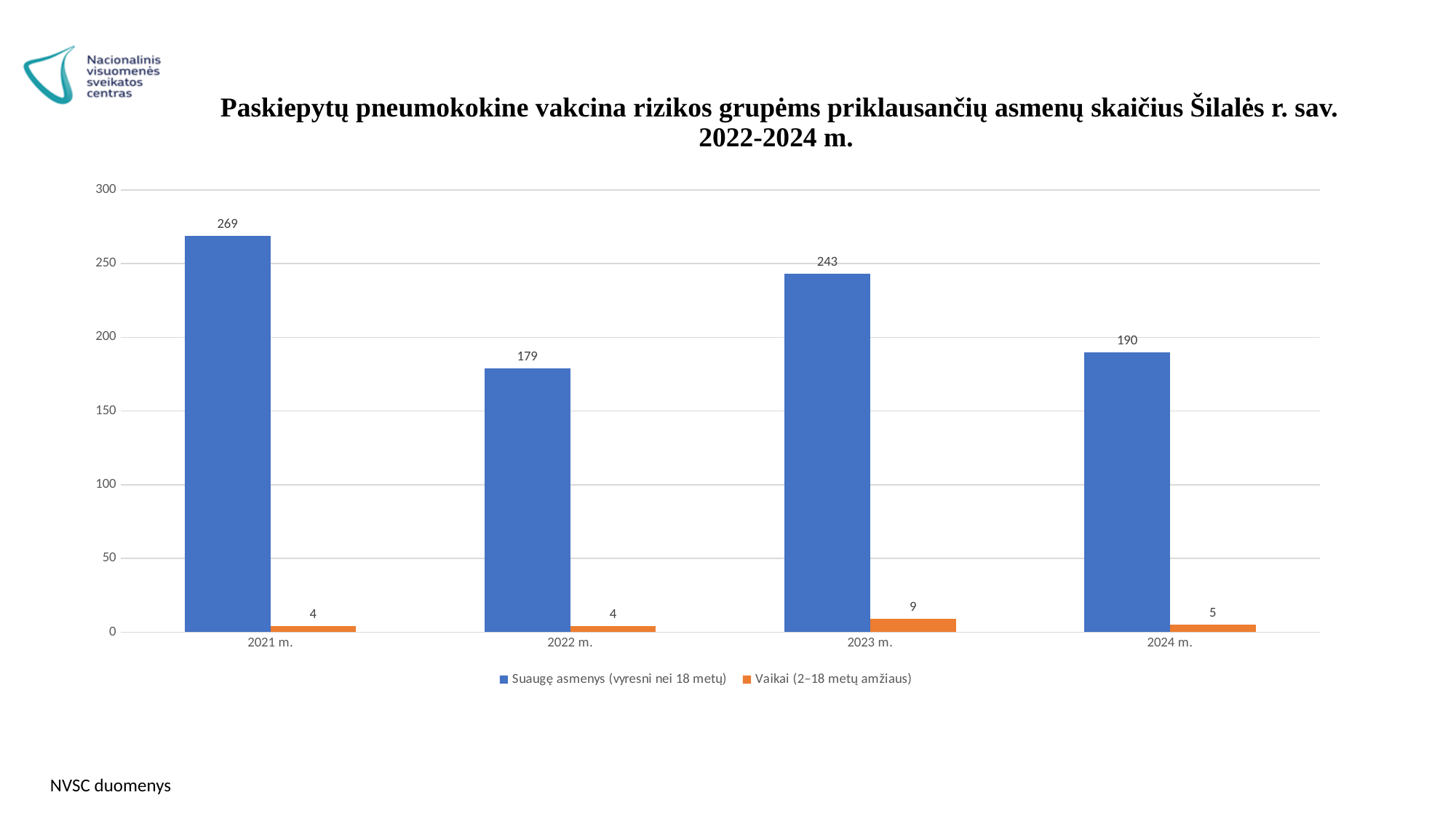
How many series does the legend list? 2 What is the value for Suaugę asmenys (vyresni nei 18 metų) in 2024 m.? 190 In which year is the value for Suaugę asmenys (vyresni nei 18 metų) lowest? 2022 m. What is the value for Suaugę asmenys (vyresni nei 18 metų) in 2021 m.? 269 In which year is the value for Suaugę asmenys (vyresni nei 18 metų) highest? 2021 m. What colour are the bars for Vaikai (2–18 metų amžiaus)? orange What kind of chart is shown on the slide? bar chart How many years are shown on the x axis? 4 Which is larger: the Suaugę asmenys value for 2023 m. or for 2024 m.? 2023 m. Is the value for Suaugę asmenys in 2022 m. greater or less than 200? less What is the value for Vaikai (2–18 metų amžiaus) in 2023 m.? 9 What is the difference between the Suaugę asmenys values for 2021 m. and 2022 m.? 90